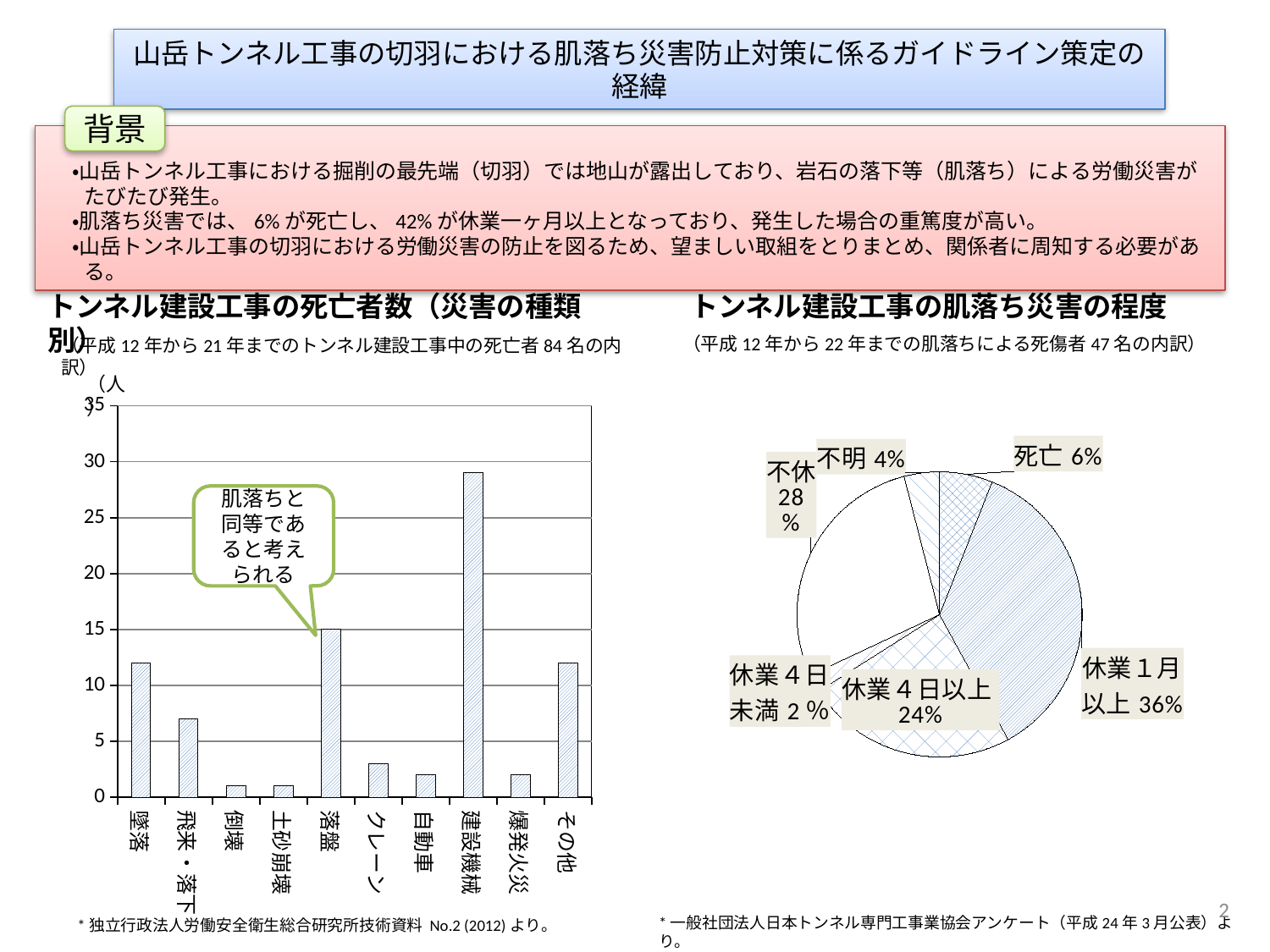
In the left bar chart, which is larger, the value for 墜落 or the value for クレーン? 墜落 In the right pie chart, how many slices are there? 6 In the left bar chart, how many categories are shown on the x axis? 10 In the right pie chart, what is the difference between the shares of 休業１月以上 and 休業４日以上? 12% In the left bar chart, which category has the highest value? 建設機械 What kind of chart is the right chart titled トンネル建設工事の肌落ち災害の程度? pie chart In the right pie chart, what share does 死亡 have? 6% In the left bar chart, is the value for 飛来・落下 greater or less than 10? less In the right pie chart, which slice is the smallest? 休業４日未満 In the right pie chart, what share does 休業１月以上 have? 36% What kind of chart is the left chart titled トンネル建設工事の死亡者数（災害の種類別）? bar chart In the left bar chart, is the value for 建設機械 greater or less than 25? greater